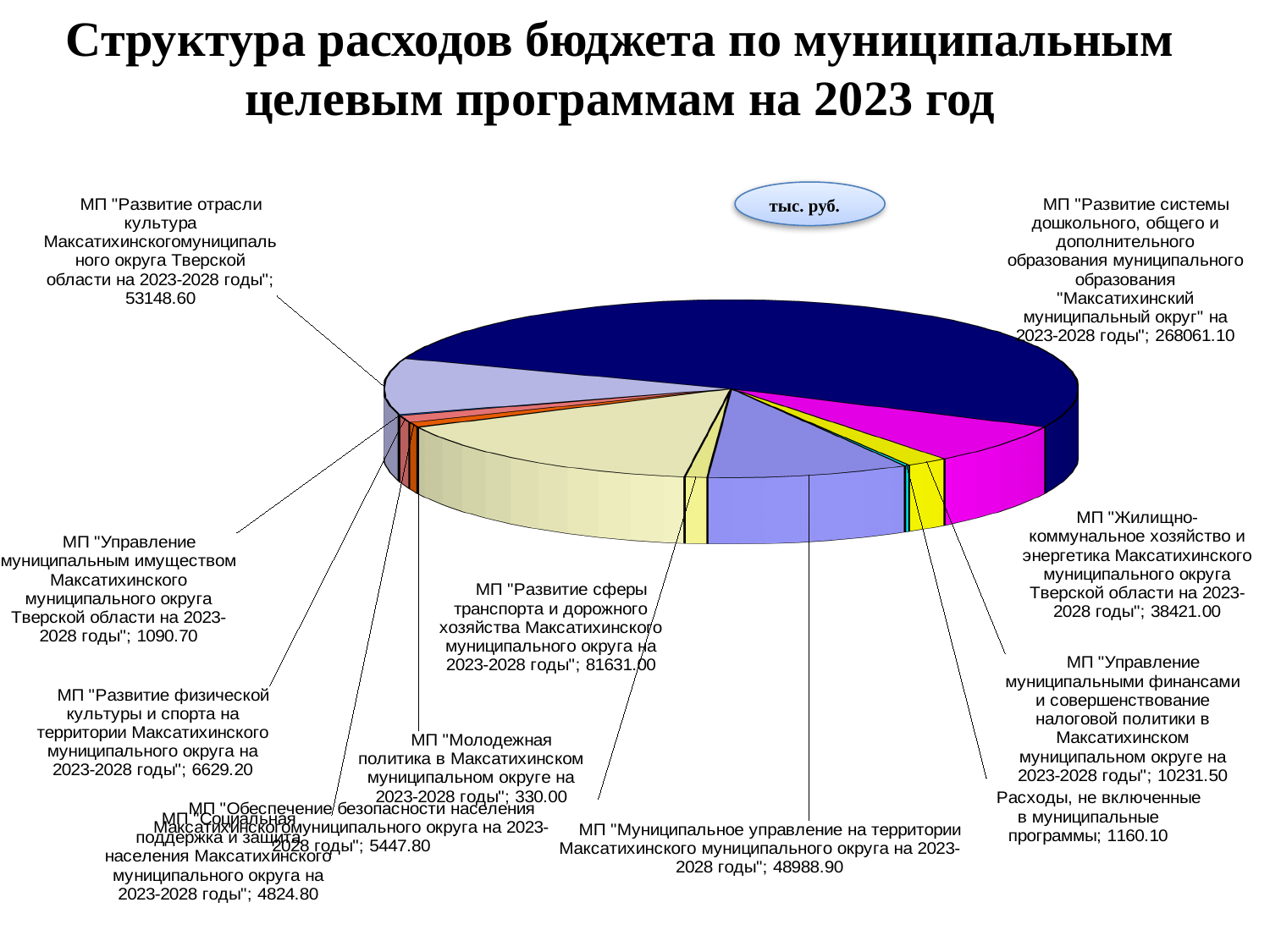
Which program has the largest slice of the pie? МП "Развитие системы дошкольного, общего и дополнительного образования муниципального образования "Максатихинский муниципальный округ" на 2023-2028 годы" In what units are the values on the chart given? тыс. руб. Which category has the smallest value in the pie chart? МП "Молодежная политика в Максатихинском муниципальном округе на 2023-2028 годы" What is the difference between the value for МП "Развитие отрасли культура..." (53148.60) and МП "Муниципальное управление на территории..." (48988.90)? 4159.70 Which is larger: the value for МП "Развитие физической культуры и спорта..." or МП "Обеспечение безопасности населения..."? МП "Развитие физической культуры и спорта..." What is the difference between the value for МП "Жилищно-коммунальное хозяйство и энергетика..." and МП "Управление муниципальными финансами..."? 28189.50 What is the value for МП "Развитие сферы транспорта и дорожного хозяйства Максатихинского муниципального округа на 2023-2028 годы"? 81631.00 What is the value for МП "Молодежная политика в Максатихинском муниципальном округе на 2023-2028 годы"? 330.00 What kind of chart is shown on the slide? Pie chart What is the value for Расходы, не включенные в муниципальные программы? 1160.10 What is the value for МП "Развитие системы дошкольного, общего и дополнительного образования муниципального образования "Максатихинский муниципальный округ" на 2023-2028 годы"? 268061.10 How many categories (slices) does the pie chart have? 12